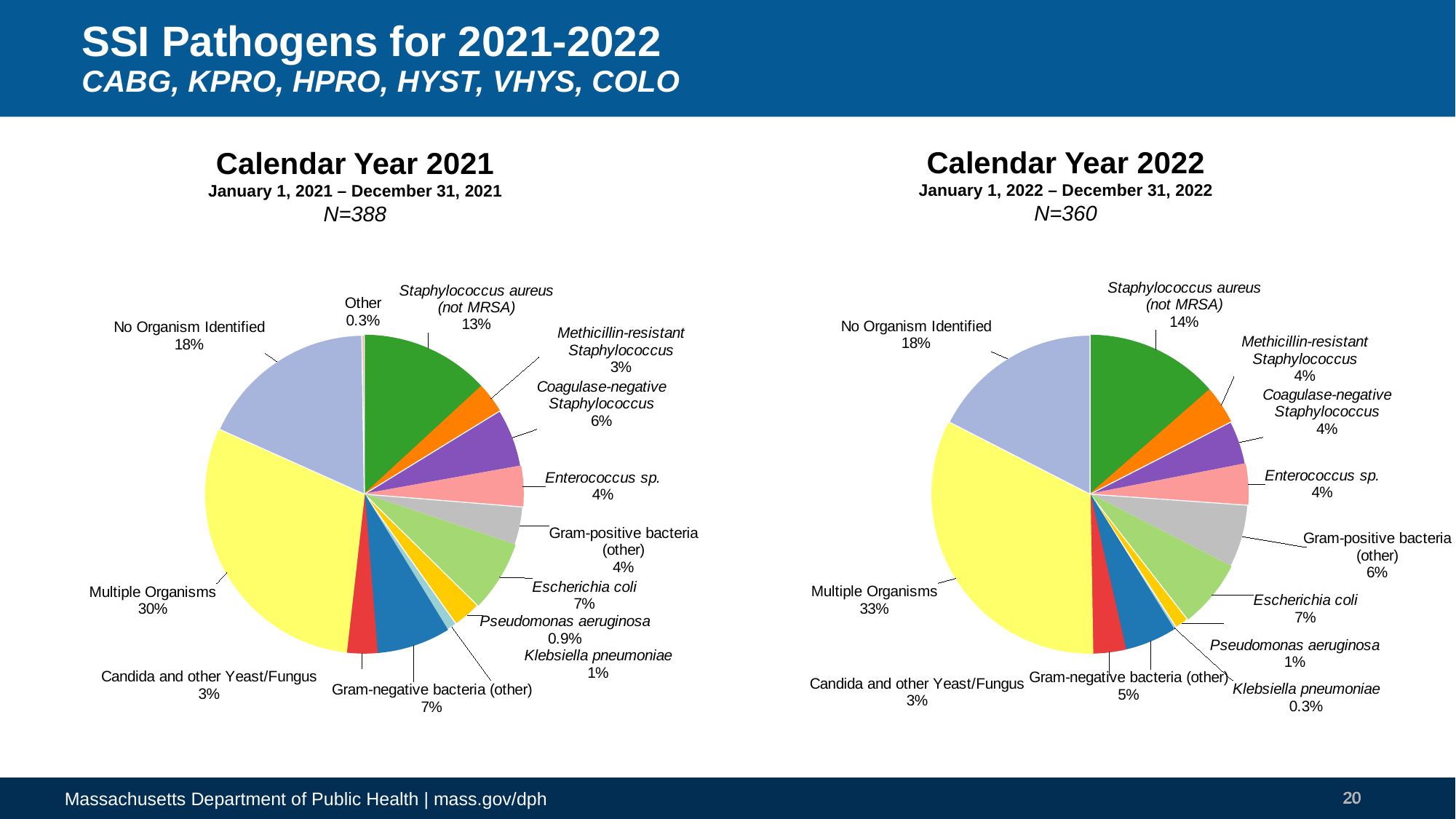
In the Calendar Year 2021 chart, what percentage is Pseudomonas aeruginosa? 0.9% How many labeled categories are shown in the Calendar Year 2021 chart? 13 In the Calendar Year 2022 chart, what percentage is Gram-negative bacteria (other)? 5% In the Calendar Year 2021 chart, which category has the smallest share? Other What is the N value shown for the Calendar Year 2022 chart? N=360 In the Calendar Year 2021 chart, what percentage is Multiple Organisms? 30% In the Calendar Year 2022 chart, which category has the largest share? Multiple Organisms What type of chart is used for Calendar Year 2021? Pie chart In the Calendar Year 2022 chart, which category has the smallest share? Klebsiella pneumoniae In the Calendar Year 2022 chart, which is larger: Gram-positive bacteria (other) or Coagulase-negative Staphylococcus? Gram-positive bacteria (other) In the Calendar Year 2022 chart, what percentage is Staphylococcus aureus (not MRSA)? 14% In the Calendar Year 2021 chart, what is the difference in percentage points between Multiple Organisms and No Organism Identified? 12